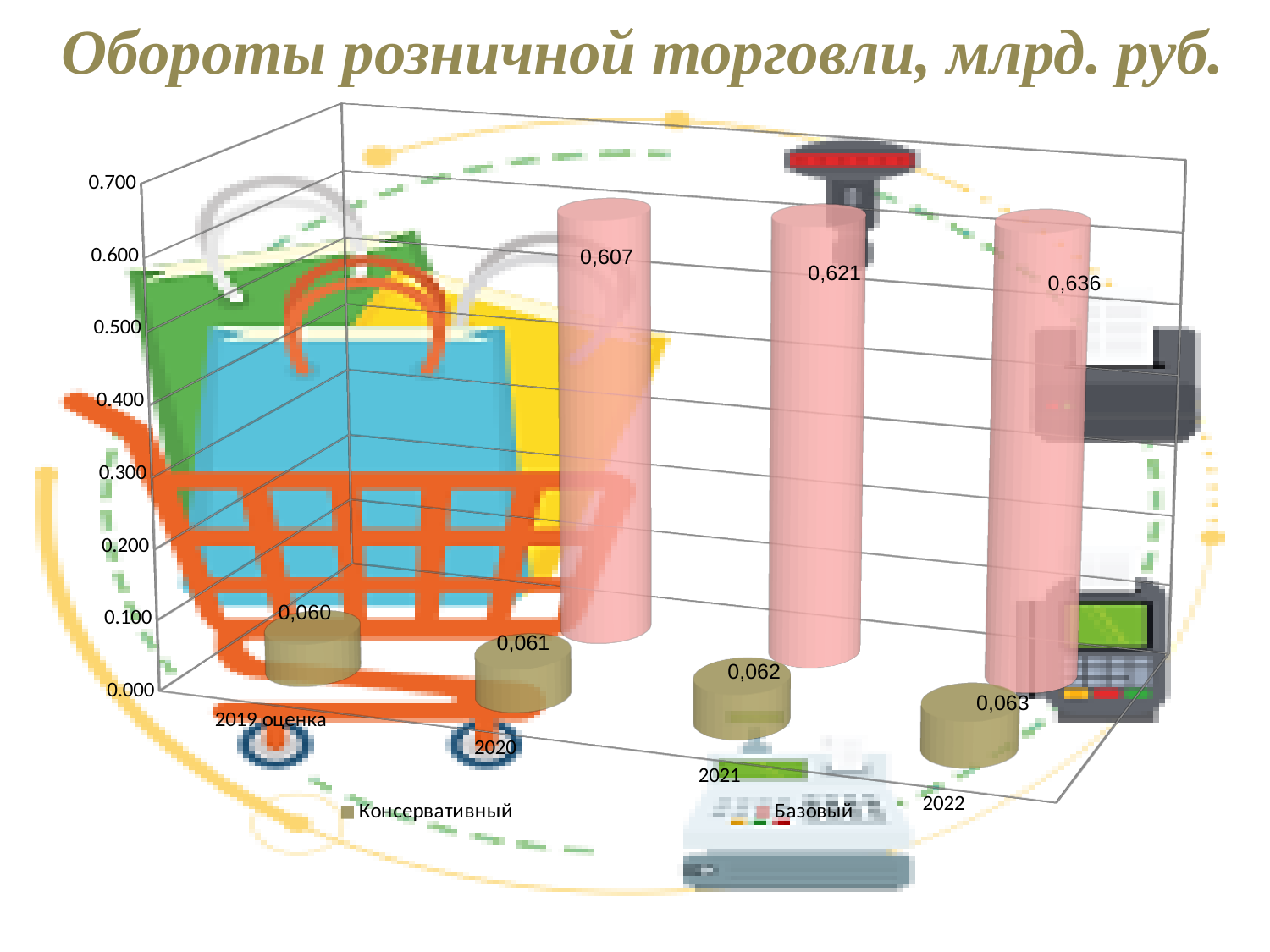
What type of chart is shown on the slide? bar chart What is the value of the Консервативный series for 2022? 0,063 What is the value of the Консервативный series for 2019 оценка? 0,060 What is the difference between the highest and lowest Базовый values (0,636 and 0,607)? 0,029 How many categories are shown on the x axis? 4 What are the two series named in the legend? Консервативный and Базовый What is the title of the chart? Обороты розничной торговли, млрд. руб. What is the lowest value shown for the Базовый series? 0,607 What is the highest value shown for the Базовый series? 0,636 Which is larger: the Консервативный value for 2020 or the Консервативный value for 2022? 2022 Do the Консервативный values rise or fall from 2019 оценка to 2022? rise How many series does the legend list? 2